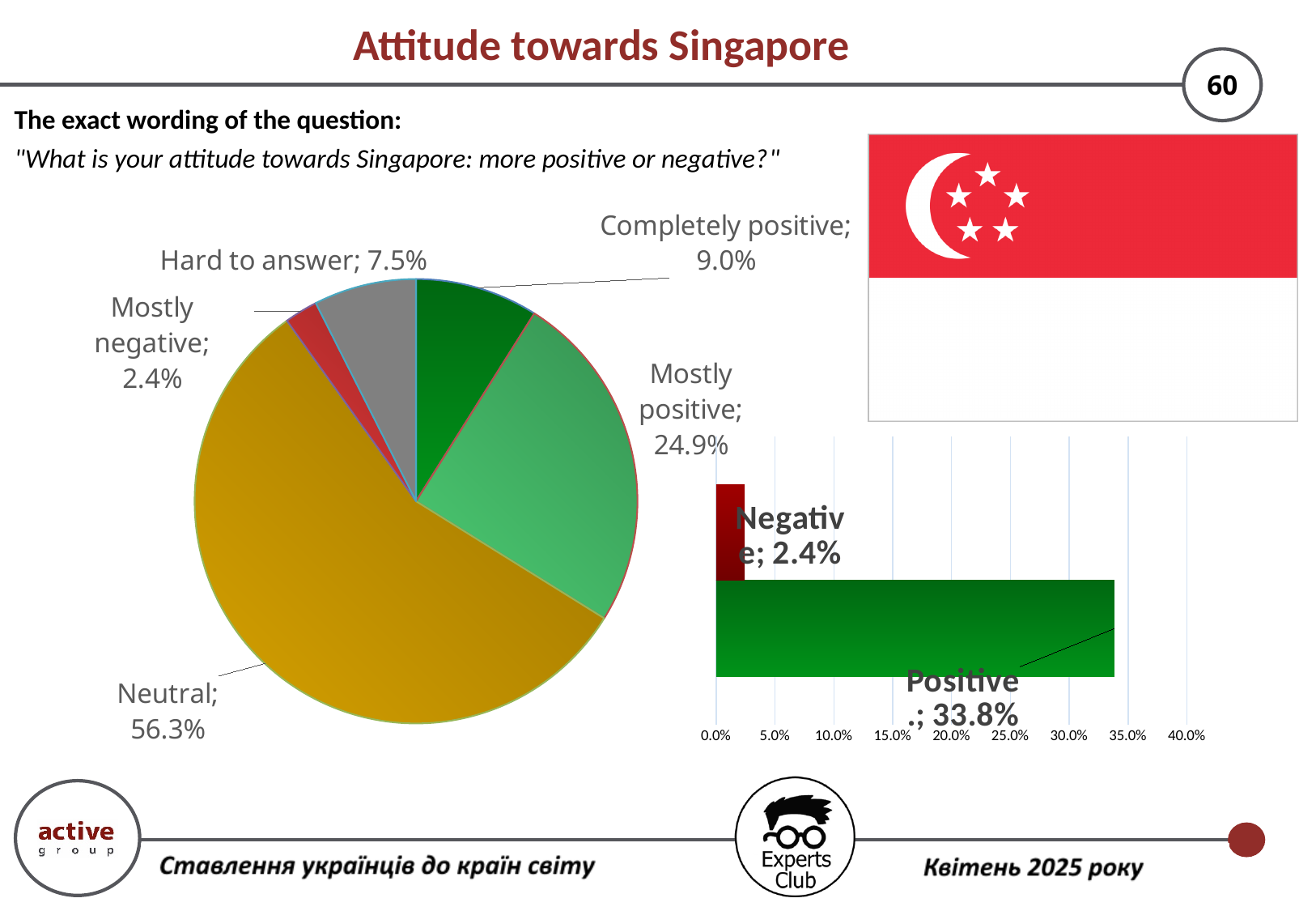
In the pie chart on the left, which is larger: Hard to answer or Mostly negative? Hard to answer In the pie chart on the left, what is the value for Completely positive? 9.0% In the pie chart on the left, how many slices are there? 5 In the pie chart on the left, which category has the smallest slice? Mostly negative In the bar chart on the right, what is the value for Positive? 33.8% In the pie chart on the left, what share is labelled Neutral? 56.3% In the bar chart on the right, what is the value for Negative? 2.4% What type of chart is shown on the right side of the slide? Bar chart In the pie chart on the left, which category has the largest slice? Neutral In the bar chart on the right, what is the difference between Positive and Negative? 31.4% In the pie chart on the left, what is the difference between Mostly positive and Completely positive? 15.9% In the pie chart on the left, what is the value for Mostly positive? 24.9%